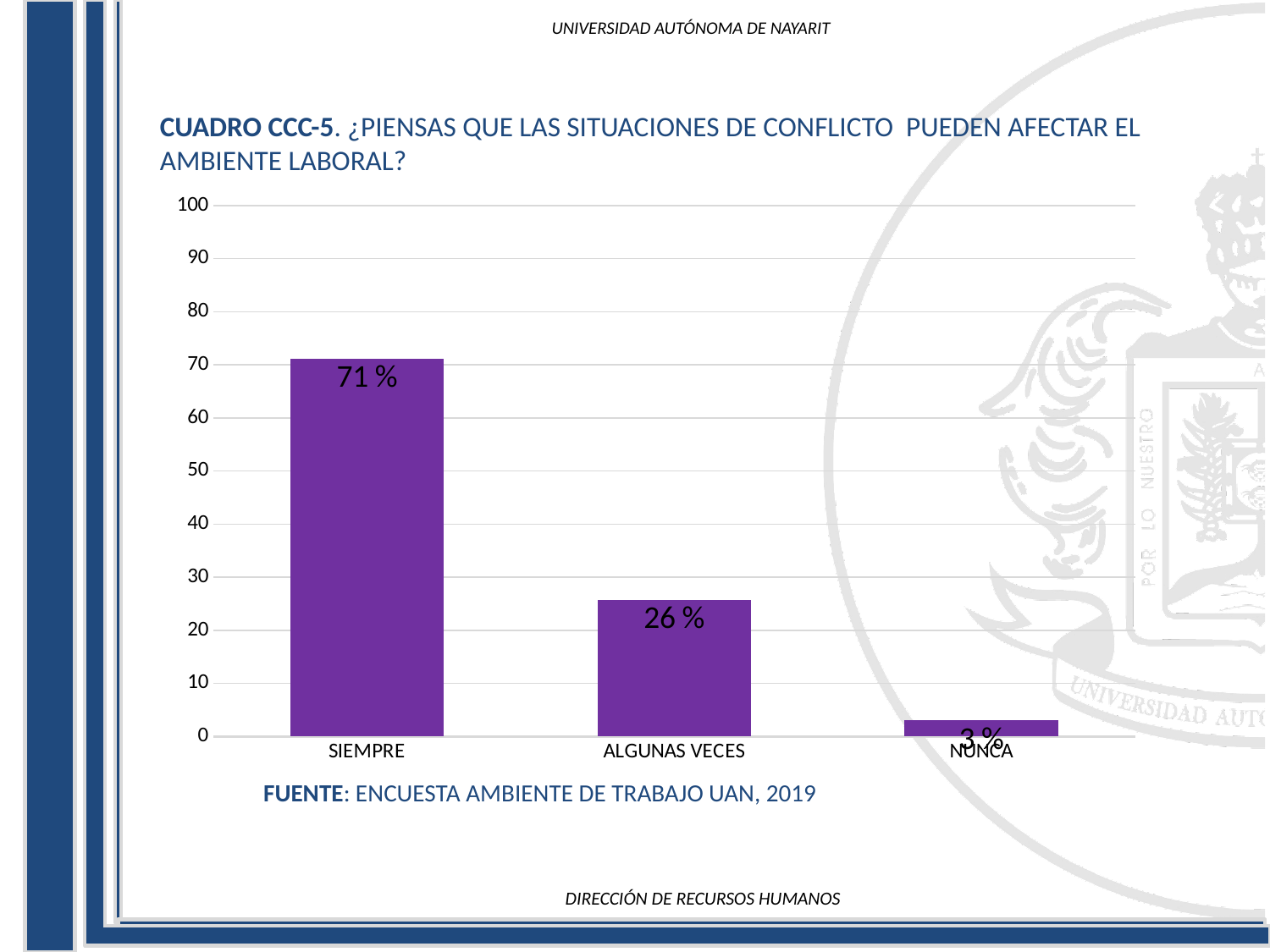
Which category has the highest value? SIEMPRE What is the difference between the values for ALGUNAS VECES and NUNCA? 23 % How many categories are shown on the x axis? 3 Which is larger, the value for ALGUNAS VECES or the value for NUNCA? ALGUNAS VECES What is the value for SIEMPRE? 71 % What kind of chart is shown on the slide? bar chart What is the value for NUNCA? 3 % What is the difference between the values for SIEMPRE and ALGUNAS VECES? 45 % Do the values rise or fall from left to right along the x axis? fall Which category has the lowest value? NUNCA Is the value for SIEMPRE greater or less than 60? greater What is the value for ALGUNAS VECES? 26 %